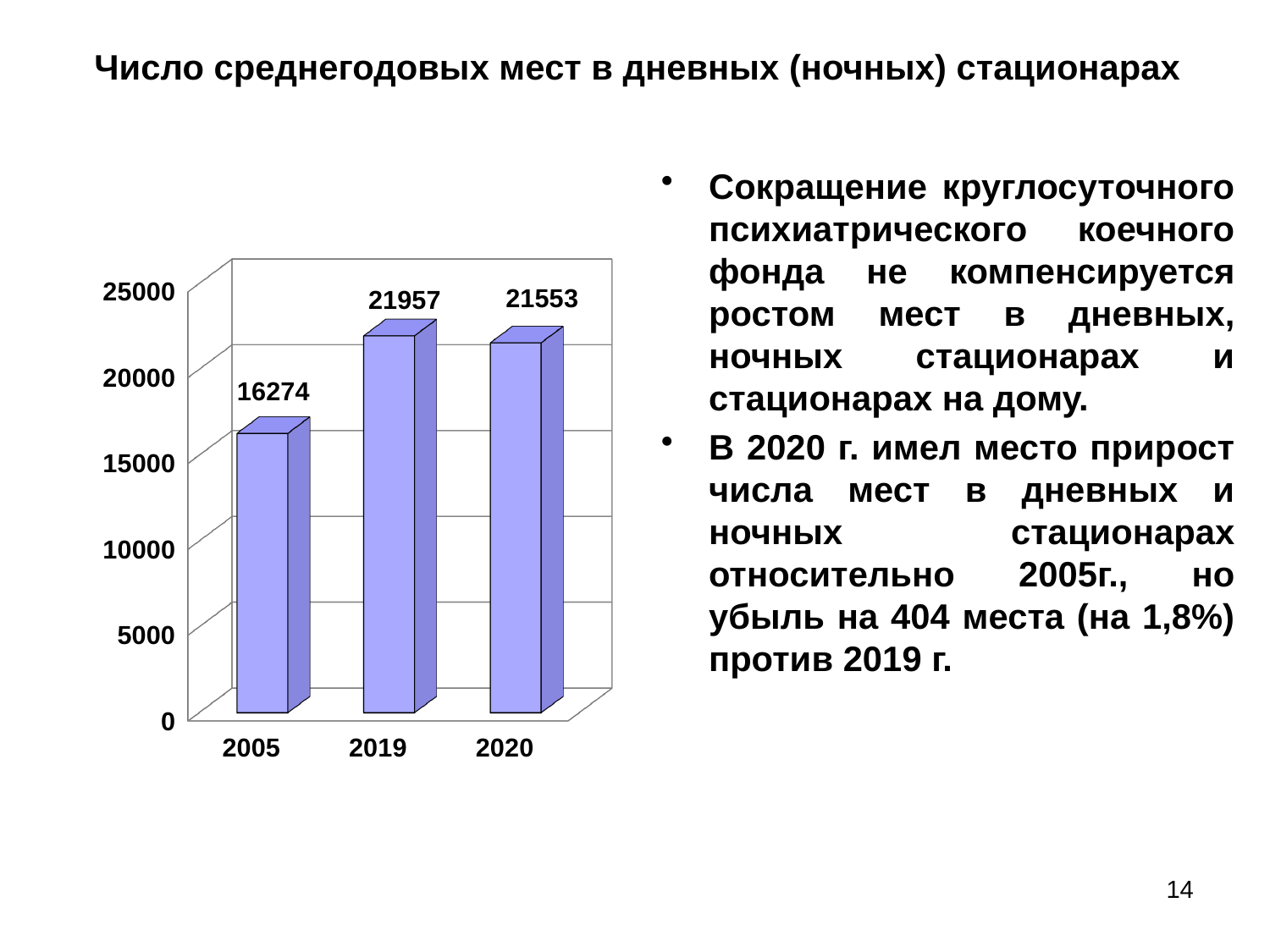
Is the value for 2005 greater or less than 15000? greater What kind of chart is shown on the slide? bar chart What is the difference between the values for 2019 and 2020? 404 Which year has the lowest value? 2005 Which is larger, the value for 2005 or the value for 2020? 2020 What is the value for 2020? 21553 What is the value for 2005? 16274 What is the title of the slide? Число среднегодовых мест в дневных (ночных) стационарах How many years are shown on the chart? 3 Which year has the highest value? 2019 What is the difference between the values for 2020 and 2005? 5279 What is the value for 2019? 21957